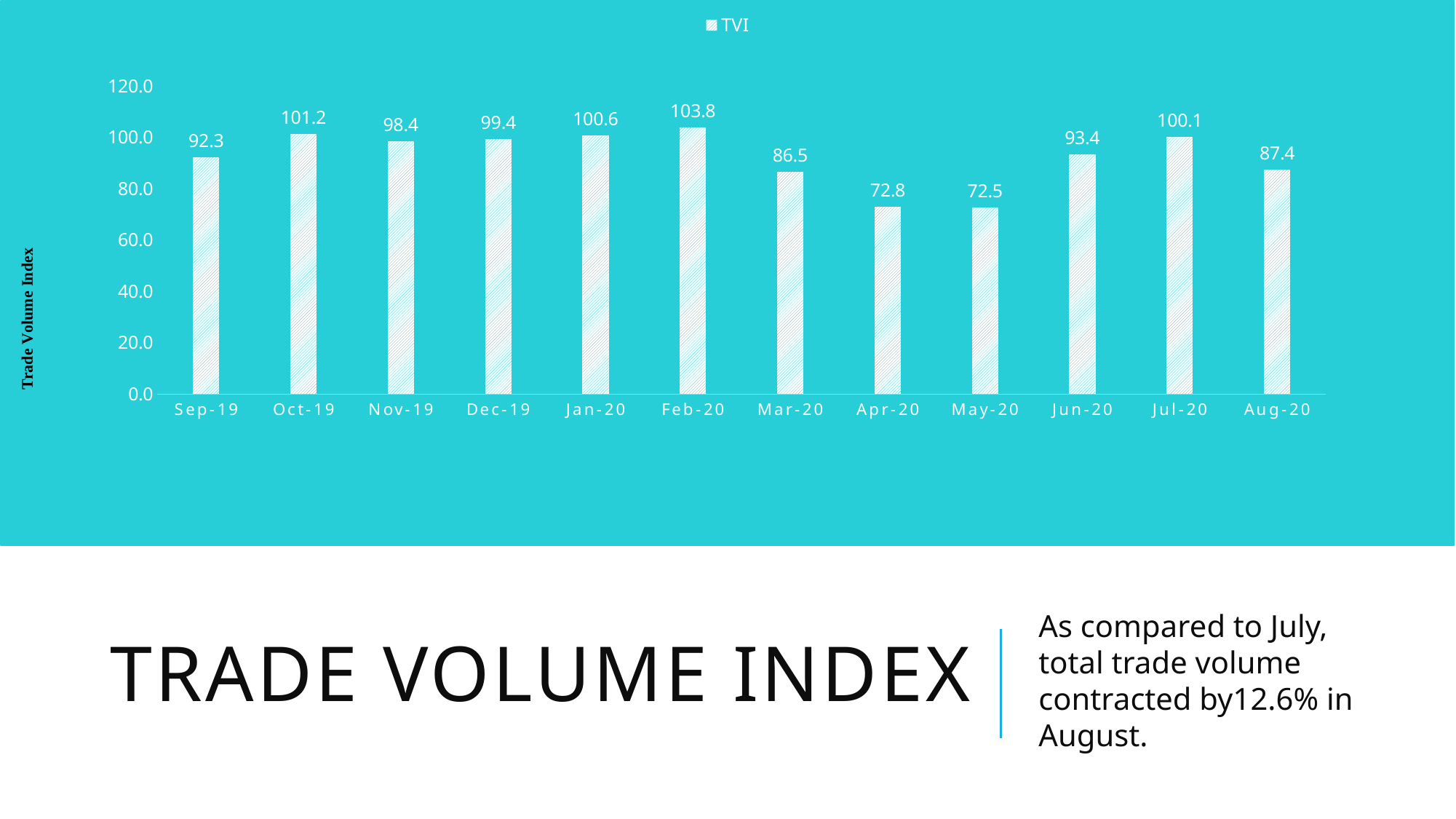
How many series does the legend list? 1 Which month has the lowest TVI value? May-20 Is the TVI value for Apr-20 greater or less than 80.0? less Which has a higher TVI value, Oct-19 or Jan-20? Oct-19 What is the TVI value for Feb-20? 103.8 What is the TVI value for Mar-20? 86.5 What is the TVI value for Aug-20? 87.4 Which month has the highest TVI value? Feb-20 How many months are shown on the x axis? 12 What is the label on the vertical axis of the chart? Trade Volume Index What is the difference between the TVI values for Jul-20 and Aug-20? 12.7 What kind of chart is shown on the slide? bar chart